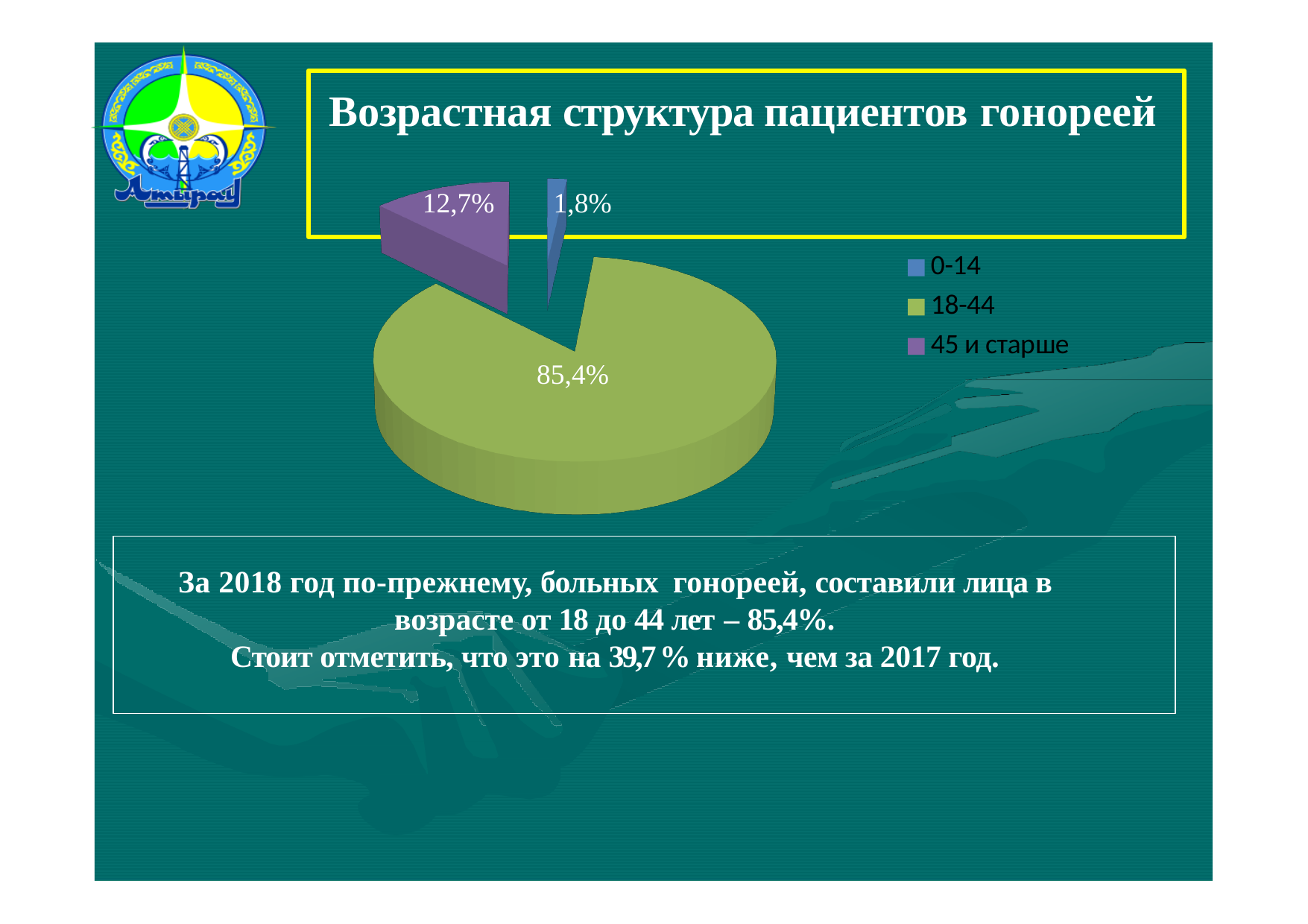
What is the difference in percentage points between the 45 и старше group and the 0-14 group? 10,9 What share of gonorrhea patients are in the 18-44 age group? 85,4% What share of gonorrhea patients are aged 45 and older (45 и старше)? 12,7% Which age group has the largest share of gonorrhea patients? 18-44 What type of chart is shown on the slide? Pie chart Which age group has the smallest share of gonorrhea patients? 0-14 Which colour represents the 45 и старше group in the legend? Purple Which has a larger share: the 0-14 group or the 45 и старше group? 45 и старше What is the title of the chart? Возрастная структура пациентов гонореей What share of gonorrhea patients are in the 0-14 age group? 1,8% How many age groups are shown in the pie chart? 3 What is the difference in percentage points between the 18-44 group and the 45 и старше group? 72,7